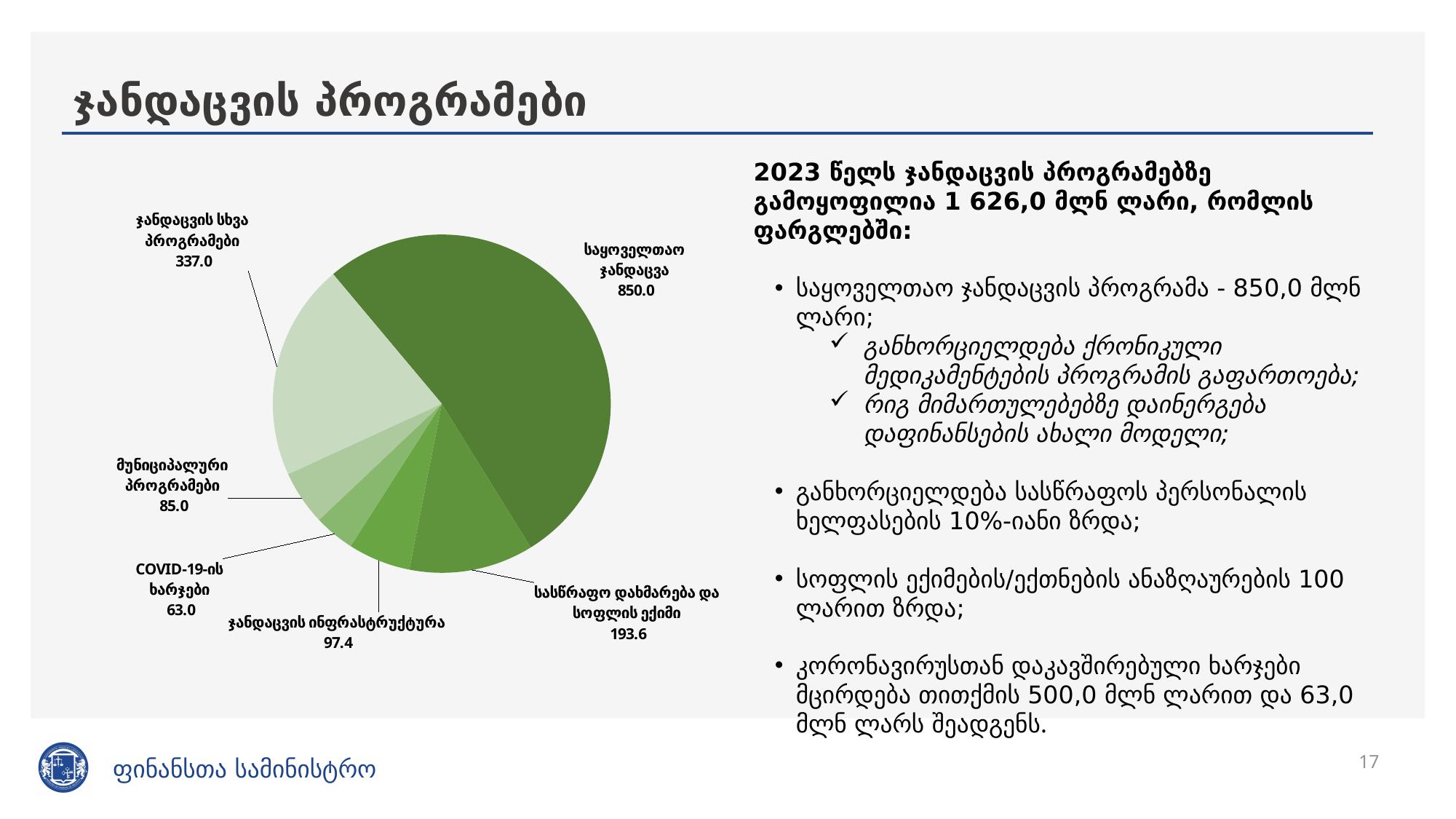
How many slices does the pie chart have? 6 What is the value for COVID-19-ის ხარჯები in the pie chart? 63.0 Which category has the smallest slice in the pie chart? COVID-19-ის ხარჯები Which is larger in the pie chart: მუნიციპალური პროგრამები or ჯანდაცვის ინფრასტრუქტურა? ჯანდაცვის ინფრასტრუქტურა What is the difference between the values for საყოველთაო ჯანდაცვა and ჯანდაცვის სხვა პროგრამები? 513.0 What is the value for საყოველთაო ჯანდაცვა in the pie chart? 850.0 What is the value for სასწრაფო დახმარება და სოფლის ექიმი in the pie chart? 193.6 What is the value for ჯანდაცვის სხვა პროგრამები in the pie chart? 337.0 What is the value for ჯანდაცვის ინფრასტრუქტურა in the pie chart? 97.4 What kind of chart is shown on the slide? Pie chart What is the total of all slices in the pie chart? 1626.0 Which category has the largest slice in the pie chart? საყოველთაო ჯანდაცვა